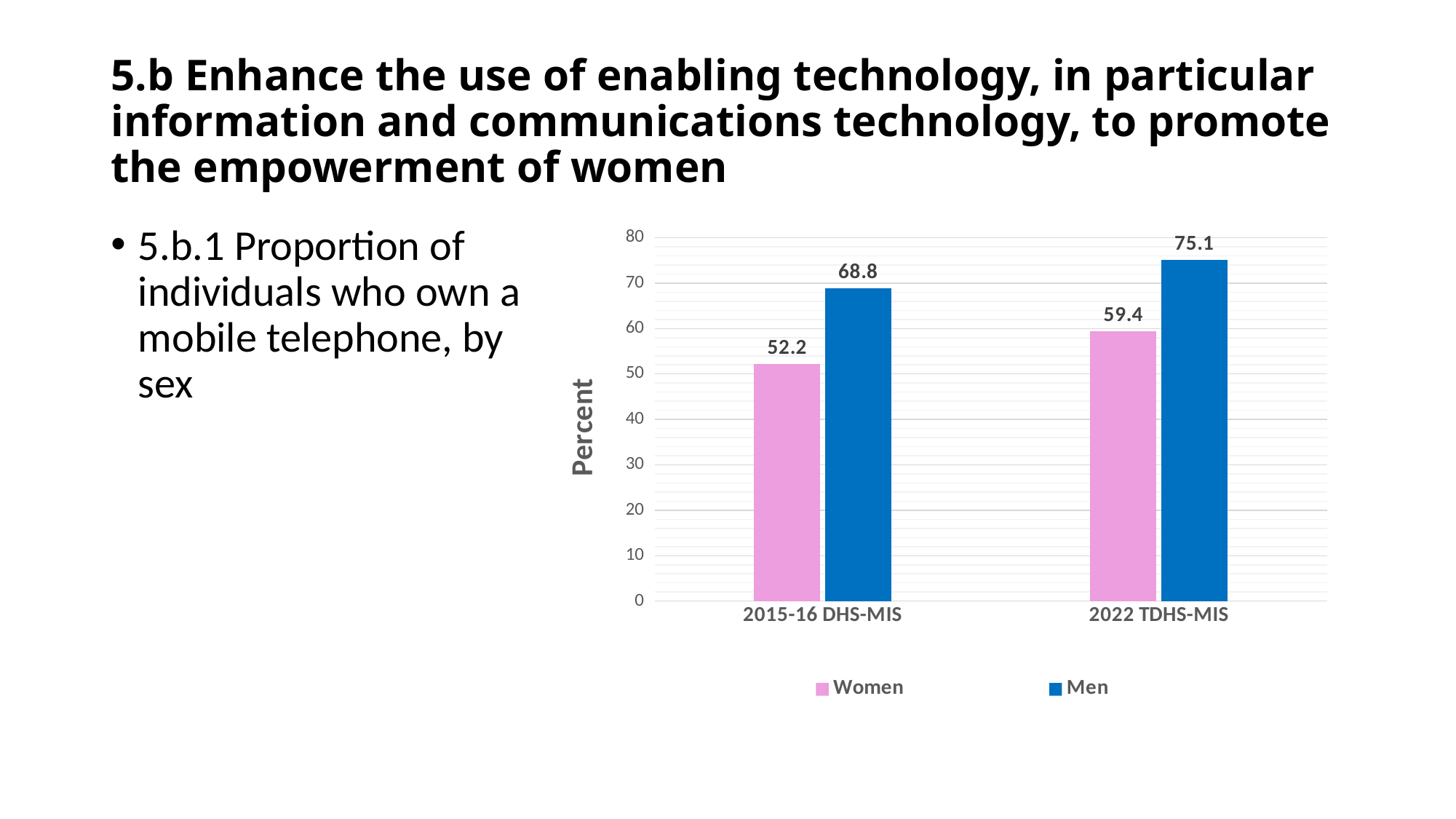
What is the difference between the Men and Women values in 2022 TDHS-MIS? 15.7 What is the value for Men in 2015-16 DHS-MIS? 68.8 How many series does the legend list? 2 Which is larger: the Women value in 2022 TDHS-MIS or the Men value in 2015-16 DHS-MIS? Men value in 2015-16 DHS-MIS What is the value for Women in 2022 TDHS-MIS? 59.4 What is the difference between the Women values in 2022 TDHS-MIS and 2015-16 DHS-MIS? 7.2 Which bar has the lowest value on the chart? Women, 2015-16 DHS-MIS What is the value for Men in 2022 TDHS-MIS? 75.1 What kind of chart is shown on the slide? Bar chart Do the Men values rise or fall from 2015-16 DHS-MIS to 2022 TDHS-MIS? Rise What is the value for Women in 2015-16 DHS-MIS? 52.2 Which bar has the highest value on the chart? Men, 2022 TDHS-MIS